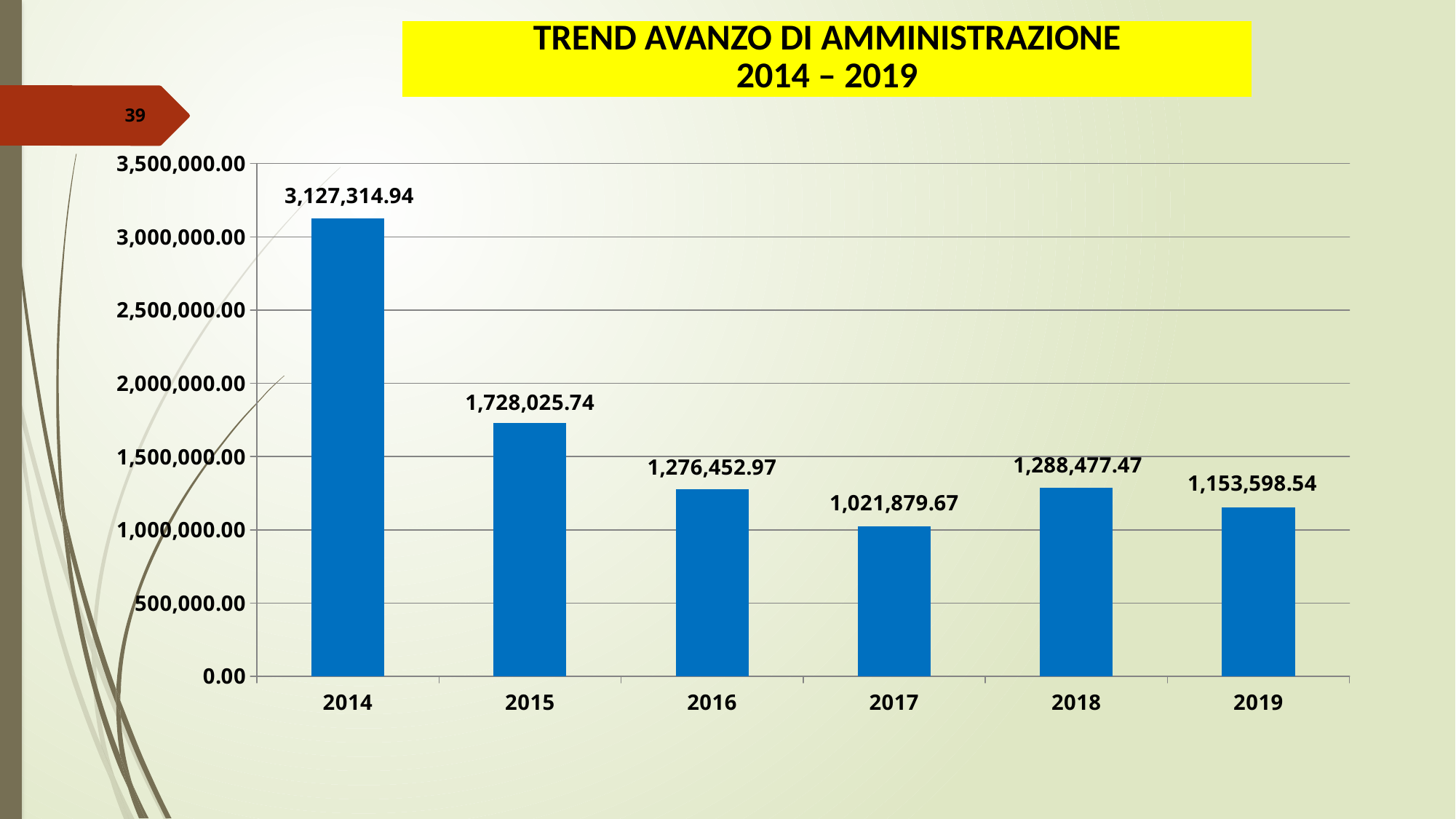
Do the values rise or fall from 2014 to 2017? fall Which is larger, the value for 2015 or the value for 2019? 2015 What kind of chart is shown on the slide? bar chart How many years are shown on the x axis? 6 What is the value for 2014? 3,127,314.94 Which year has the highest value? 2014 Is the value for 2015 greater or less than 2,000,000.00? less What is the difference between the values for 2018 and 2019? 134,878.93 What is the difference between the values for 2014 and 2015? 1,399,289.20 What is the value for 2017? 1,021,879.67 Which year has the lowest value? 2017 What is the value for 2019? 1,153,598.54